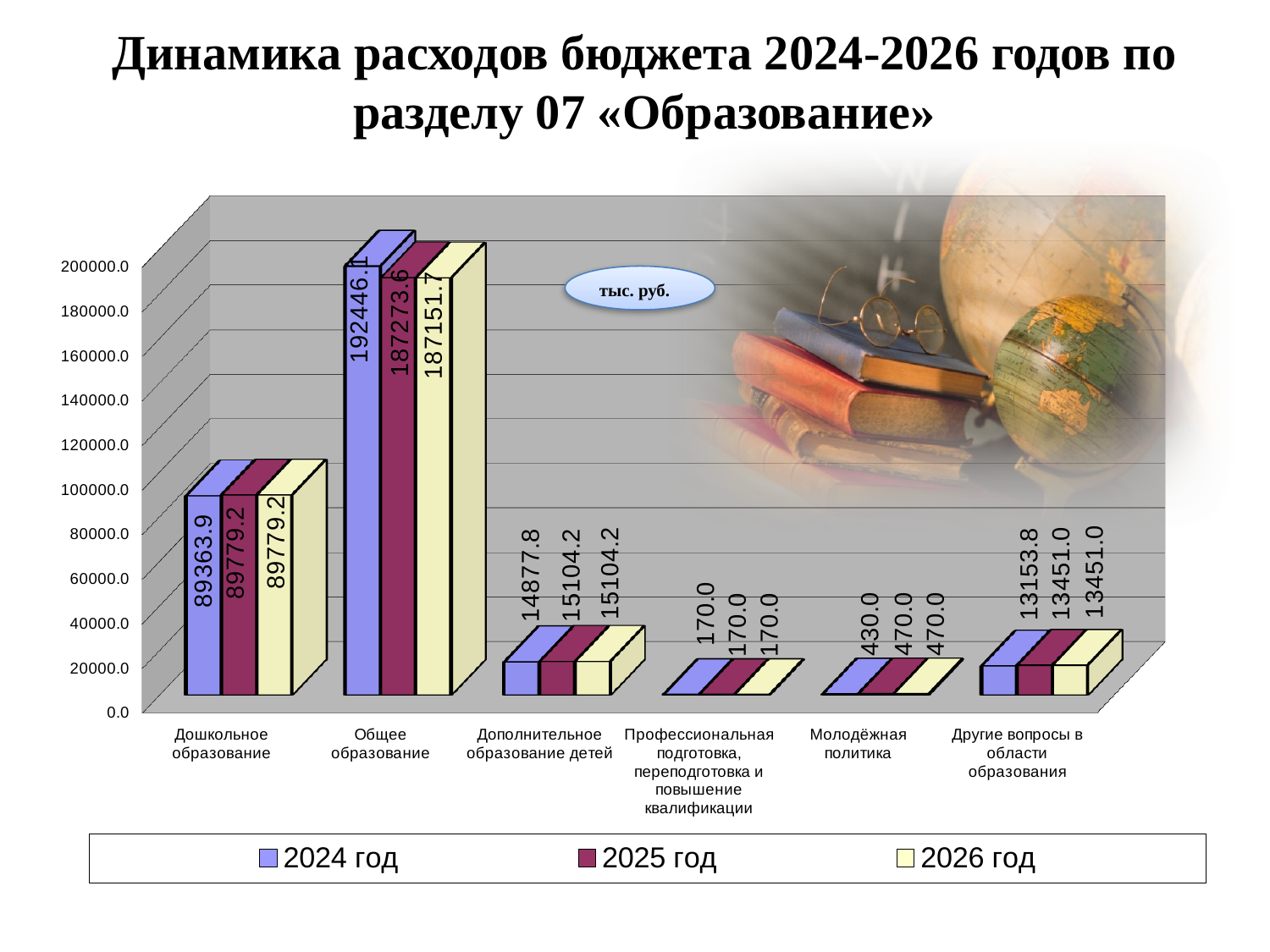
What is the value for Молодёжная политика in 2026 год? 470.0 Which category has the lowest value in 2024 год? Профессиональная подготовка, переподготовка и повышение квалификации Which category has the highest value in 2026 год? Общее образование What is the value for Общее образование in 2025 год? 187273.6 What is the difference between the 2025 год and 2024 год values for Дошкольное образование? 415.3 How many series does the legend list? 3 In 2024 год, which is larger: Дополнительное образование детей or Другие вопросы в области образования? Дополнительное образование детей What is the value for Дошкольное образование in 2024 год? 89363.9 What is the value for Другие вопросы в области образования in 2026 год? 13451.0 What unit is indicated in the label on the chart? тыс. руб. How many categories are shown on the x axis? 6 What is the difference between the 2025 год and 2026 год values for Общее образование? 121.9